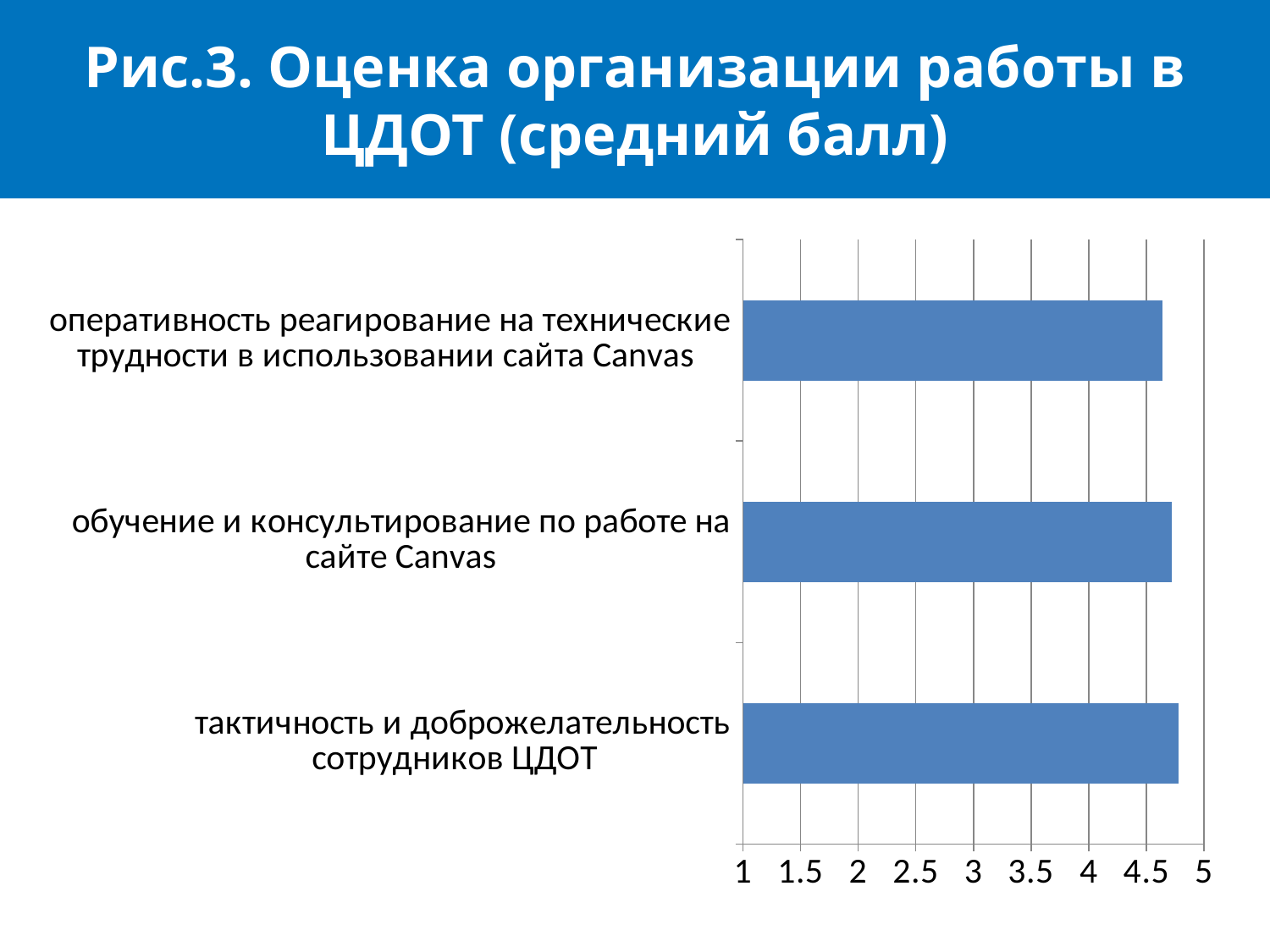
What kind of chart is shown on the slide? bar chart Is the value for 'тактичность и доброжелательность сотрудников ЦДОТ' greater or less than 4? greater What is the title of the chart on the slide? Рис.3. Оценка организации работы в ЦДОТ (средний балл) How many categories are plotted in the chart? 3 Is the value for 'тактичность и доброжелательность сотрудников ЦДОТ' greater or less than 5? less Which is larger: the value for 'тактичность и доброжелательность сотрудников ЦДОТ' or the value for 'оперативность реагирование на технические трудности в использовании сайта Canvas'? тактичность и доброжелательность сотрудников ЦДОТ Which category has the lowest value in the chart? оперативность реагирование на технические трудности в использовании сайта Canvas What is the maximum value shown on the horizontal axis of the chart? 5 Is the value for 'обучение и консультирование по работе на сайте Canvas' greater or less than 4.5? greater